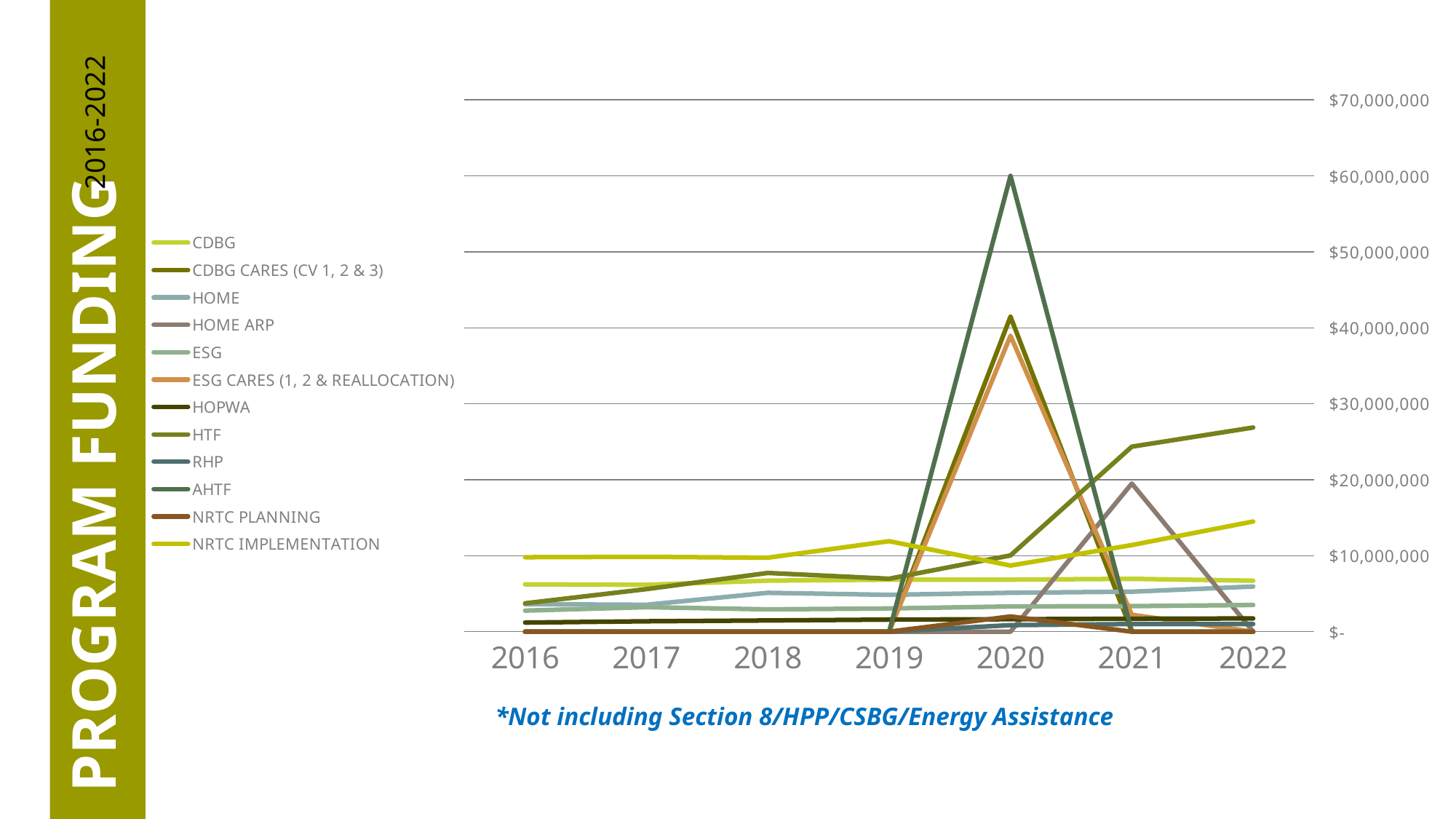
How many years are shown along the x axis? 7 How many series does the legend list? 12 In which year does the chart reach its highest peak? 2020 Which series reaches the highest value in 2020? AHTF Does the HTF line rise or fall from 2016 to 2022? Rises Is the value for HTF in 2022 greater or less than $20,000,000? greater What kind of chart is shown on the slide? Line chart In 2022, which is larger: HTF or NRTC IMPLEMENTATION? HTF Is the value for CDBG in 2016 greater or less than $10,000,000? less What is the title of the slide? PROGRAM FUNDING 2016-2022 What does the footnote below the chart say is not included? Section 8/HPP/CSBG/Energy Assistance Is the value for NRTC IMPLEMENTATION in 2022 greater or less than $10,000,000? greater